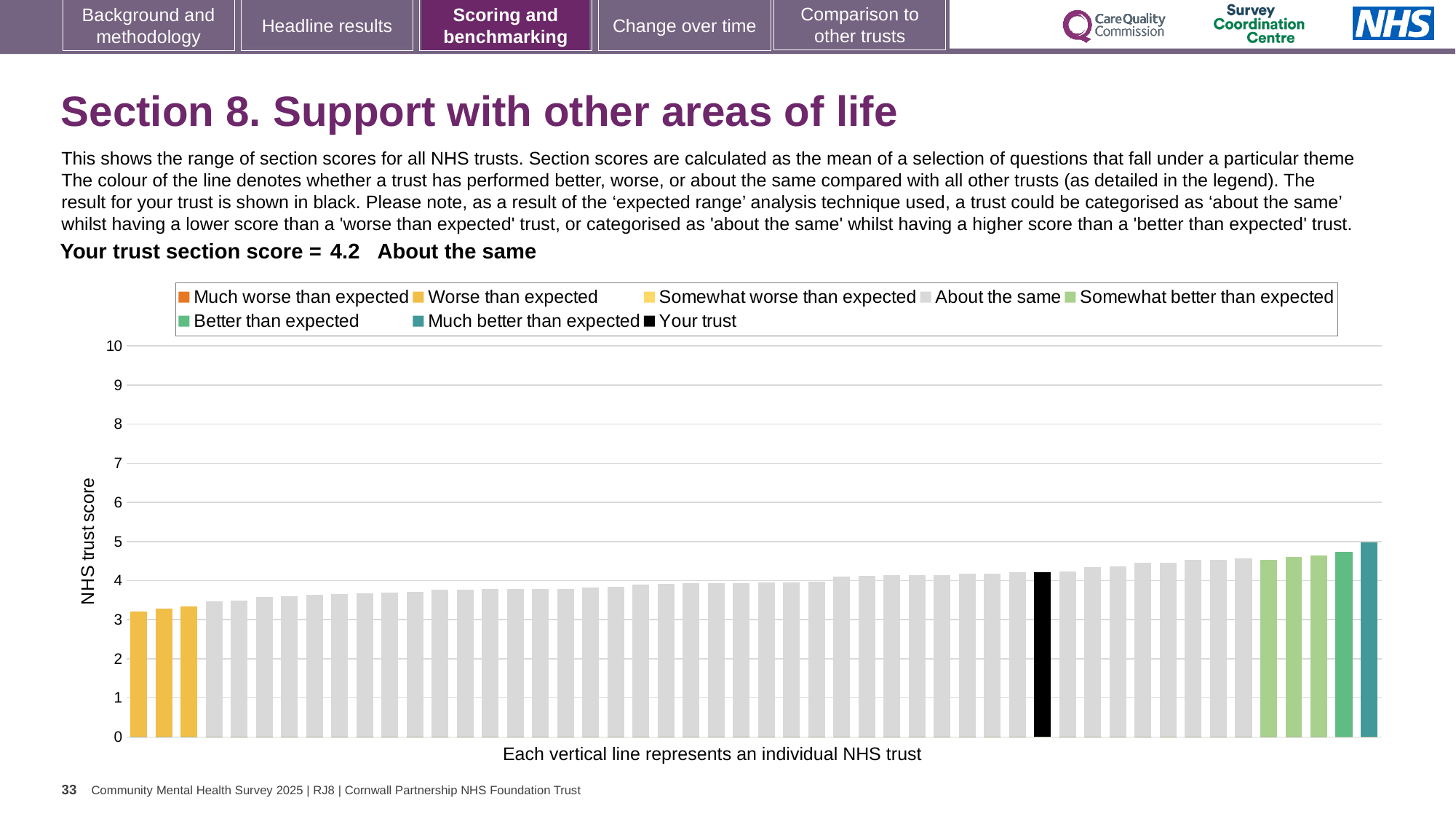
How many entries does the chart legend list? 8 How many bars are coloured as 'Worse than expected' (yellow)? 3 What kind of chart is shown on the slide? bar chart What is the label on the vertical axis of the chart? NHS trust score What is the section score for your trust shown on the slide? 4.2 Is the value of the rightmost (teal) bar greater or less than 4? greater What colour is the bar representing your trust? black Which category is your trust placed in for this section? About the same Is the value for your trust (the black bar) greater or less than 4? greater Is the bar for your trust higher or lower than the rightmost bar? lower Is the value of the leftmost bar greater or less than 3? greater Do the bar values rise or fall from left to right across the chart? rise